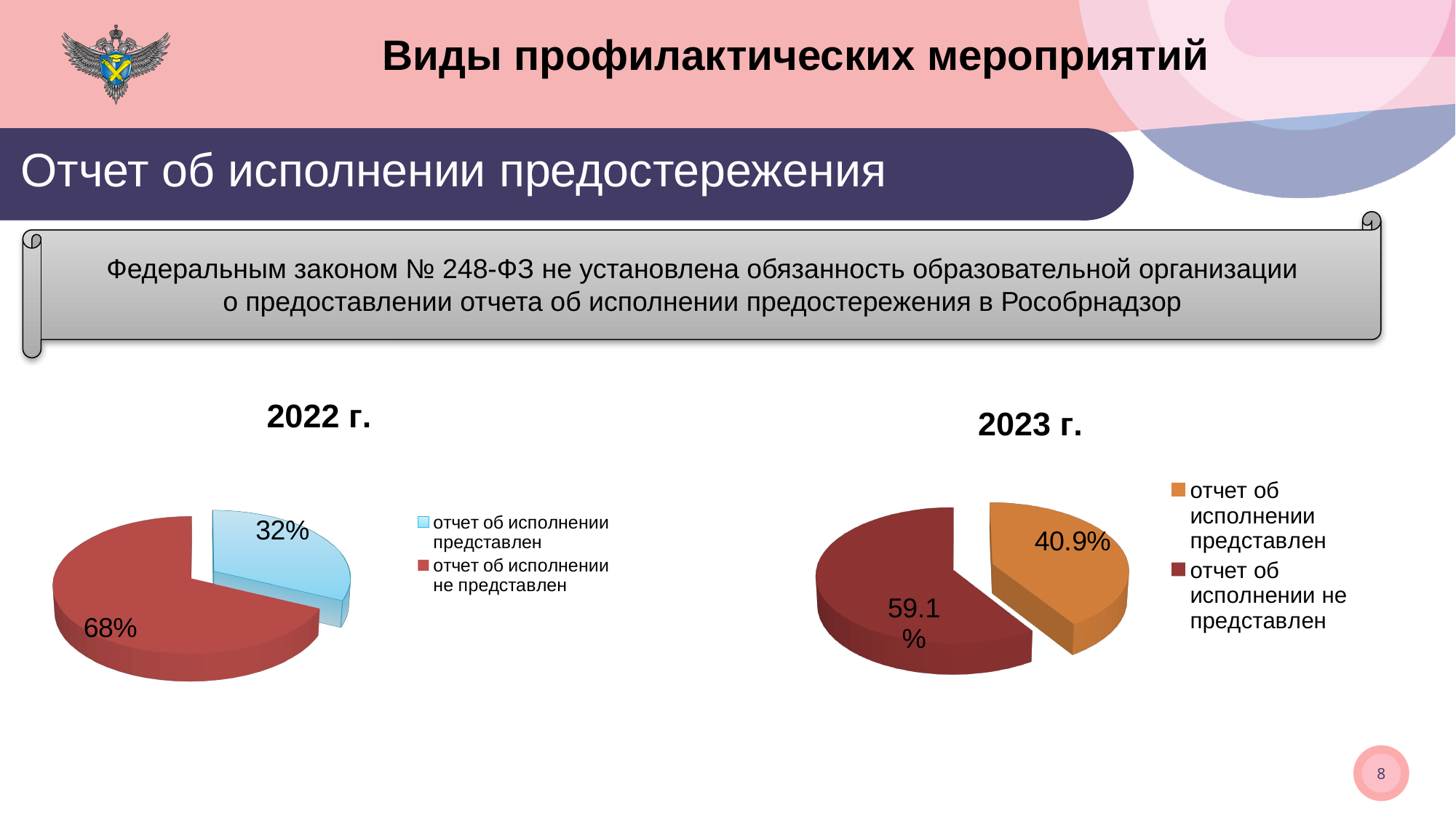
In the 2022 г. pie chart, what share is labelled for 'отчет об исполнении представлен'? 32% How many entries does the legend of the 2022 г. chart list? 2 In the 2022 г. pie chart, what share is labelled for 'отчет об исполнении не представлен'? 68% How many slices does the 2023 г. pie chart have? 2 In the 2023 г. pie chart, what share is labelled for 'отчет об исполнении не представлен'? 59.1% In the 2023 г. pie chart, what share is labelled for 'отчет об исполнении представлен'? 40.9% In the 2023 г. pie chart, which slice is the smallest? отчет об исполнении представлен What type of chart is used for 2022 г. and 2023 г.? Pie chart In the 2023 г. pie chart, what is the difference between the 'не представлен' and 'представлен' shares? 18.2% In the 2022 г. pie chart, which slice is the largest? отчет об исполнении не представлен Which is larger: the 'отчет об исполнении представлен' share in 2022 г. or in 2023 г.? 2023 г. In the 2022 г. pie chart, what is the difference between the 'не представлен' and 'представлен' shares? 36%